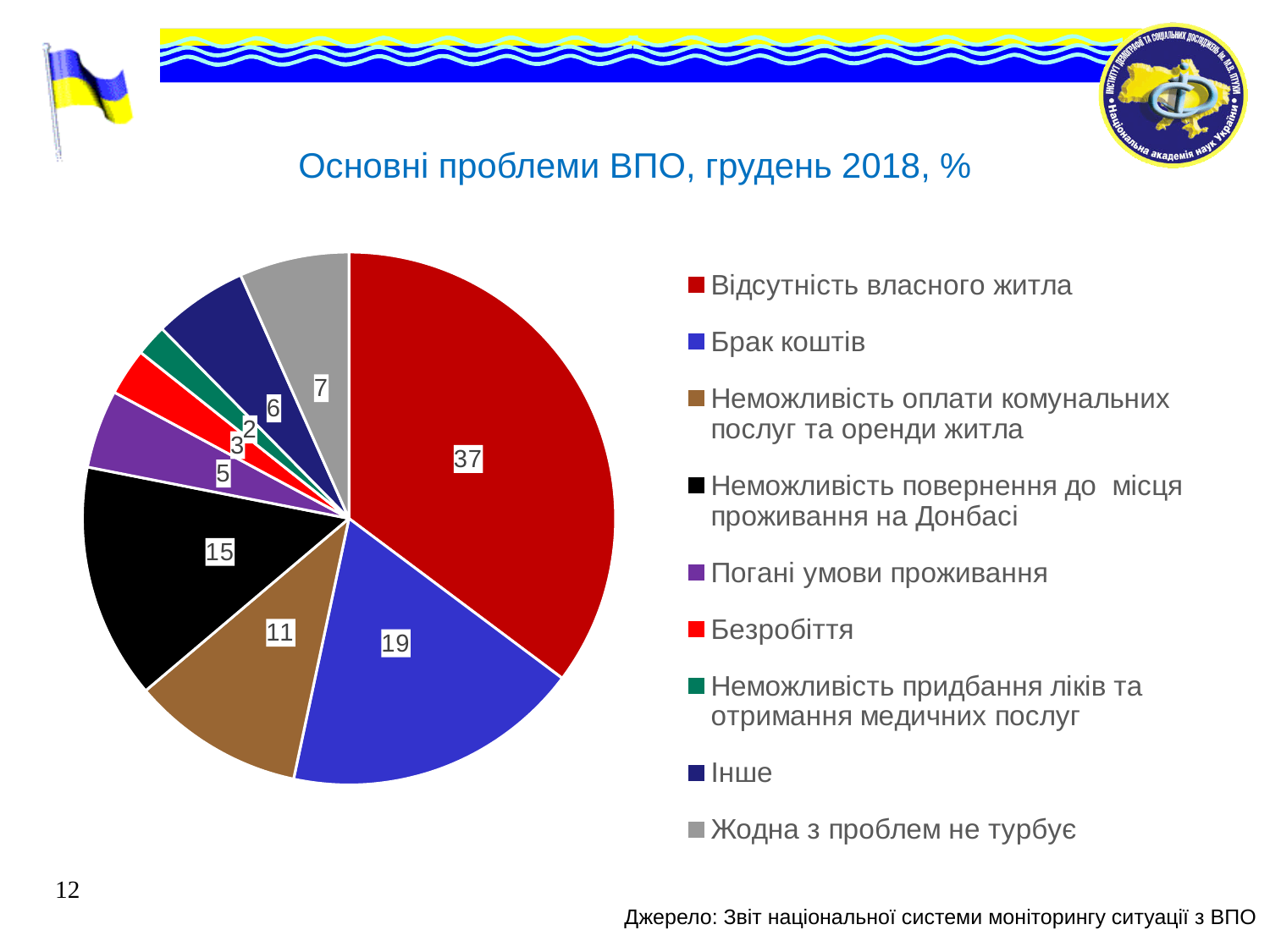
What is the difference between the values for "Відсутність власного житла" and "Брак коштів"? 18 Which category has the smallest slice of the pie? Неможливість придбання ліків та отримання медичних послуг Which is larger: the value for "Неможливість повернення до місця проживання на Донбасі" or the value for "Неможливість оплати комунальних послуг та оренди житла"? Неможливість повернення до місця проживання на Донбасі What type of chart is shown on the slide? pie chart Which category has the largest slice of the pie? Відсутність власного житла What is the value for "Брак коштів"? 19 What is the value for "Відсутність власного житла"? 37 What is the title of the chart? Основні проблеми ВПО, грудень 2018, % How many categories does the pie chart have? 9 What is the value for "Жодна з проблем не турбує"? 7 What colour is the slice for "Безробіття"? red What is the value for "Неможливість повернення до місця проживання на Донбасі"? 15